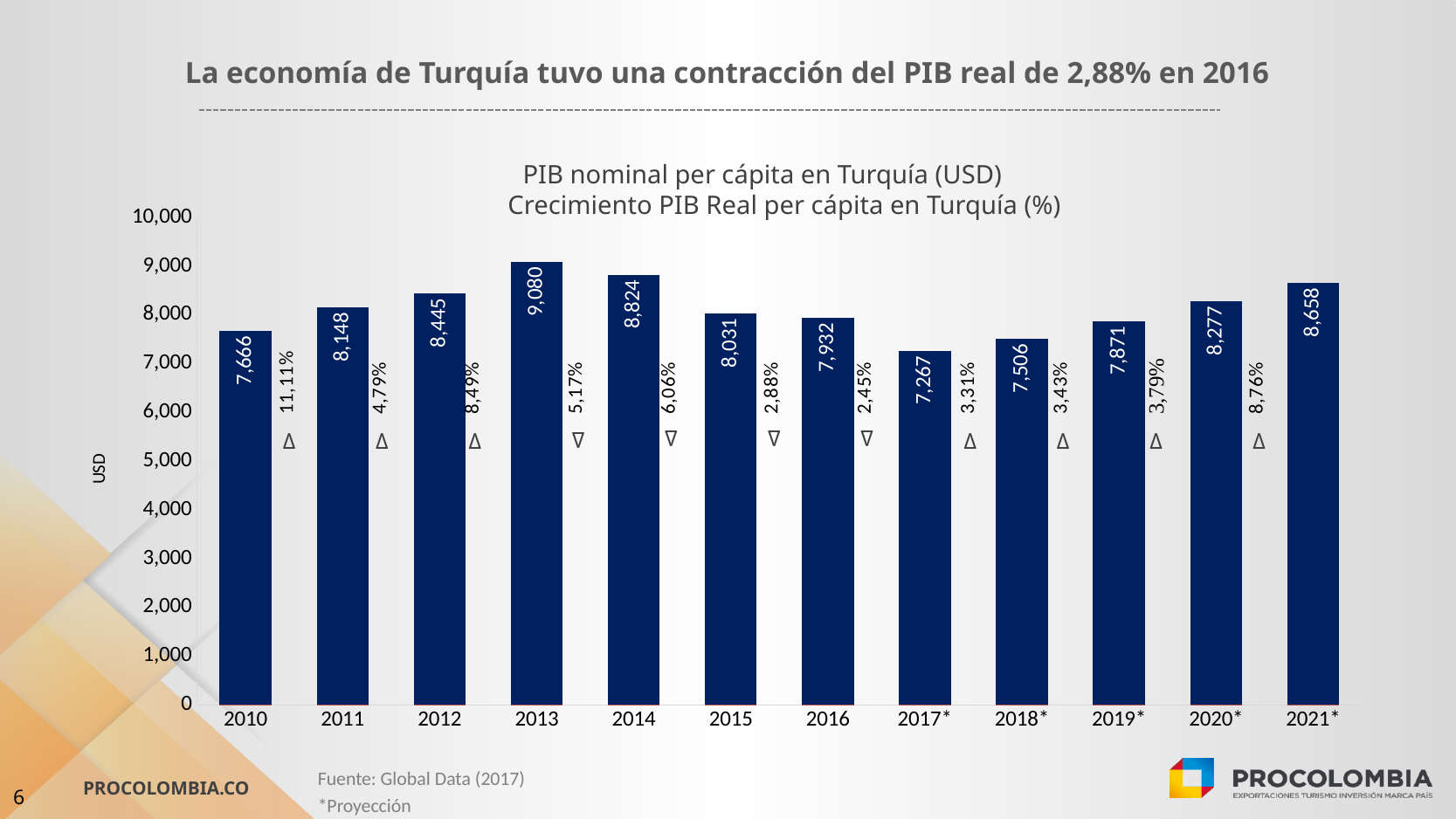
How many years are shown on the x axis of the chart? 12 What is the difference between the PIB nominal per cápita values for 2013 and 2014? 256 What is the PIB nominal per cápita value for 2021*? 8,658 Which is larger, the PIB nominal per cápita for 2011 or for 2020*? 2020* Do the PIB nominal per cápita values rise or fall from 2013 to 2017*? fall What is the PIB nominal per cápita value for 2017*? 7,267 What is the difference between the PIB nominal per cápita values for 2021* and 2020*? 381 What is the PIB nominal per cápita value for 2013? 9,080 Is the PIB nominal per cápita value for 2010 greater or less than 8,000? less Which year has the lowest PIB nominal per cápita? 2017* What kind of chart is shown on the slide? bar chart Which year has the highest PIB nominal per cápita? 2013